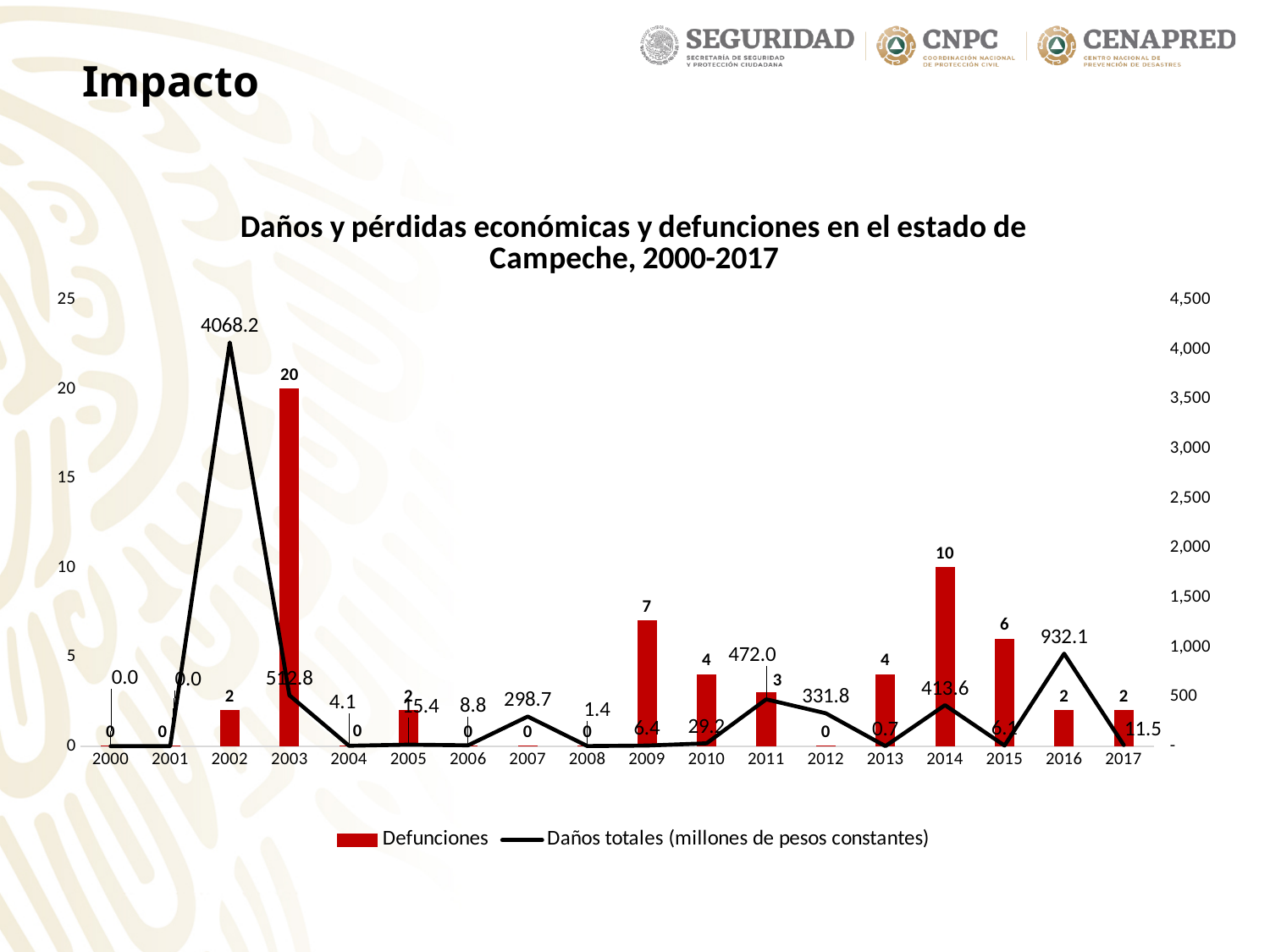
Which year has a larger value of Daños totales, 2011 or 2012? 2011 What kind of chart is shown on the slide? Combined bar and line chart What is the value of Daños totales for 2007? 298.7 Which year has the highest value of Daños totales? 2002 What is the value of Daños totales (millones de pesos constantes) for 2002? 4068.2 Which year has the highest number of Defunciones? 2003 What is the value of Daños totales for 2016? 932.1 What is the difference in Defunciones between 2014 and 2009? 3 How many series does the legend list? 2 How many years are shown on the x axis of the chart? 18 How many deaths (Defunciones) are shown for 2003? 20 How many Defunciones are shown for 2014? 10